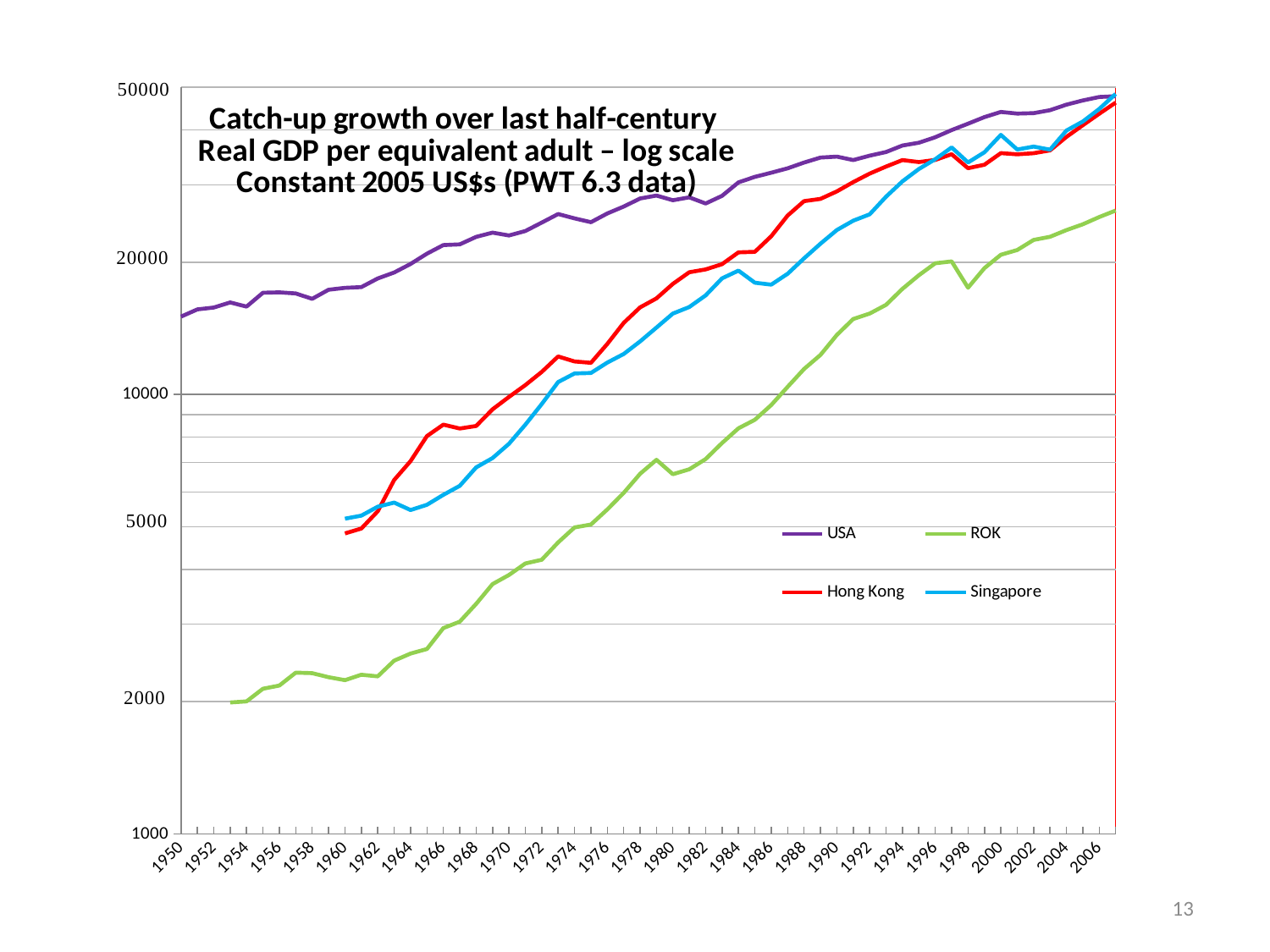
Which four series are listed in the legend? USA, ROK, Hong Kong, Singapore Which is lower in 2006, ROK or Hong Kong? ROK Does the USA series rise or fall over the period from 1950 to 2006? rise How many series does the legend list? 4 Which series has the lowest value in 2000? ROK Is the value for ROK in 1960 greater or less than 5000? less Which is higher in 1980, USA or ROK? USA What is the title of the chart? Catch-up growth over last half-century Real GDP per equivalent adult – log scale Constant 2005 US$s (PWT 6.3 data) Is the value for USA in 1950 greater or less than 10000? greater Is the value for Hong Kong in 1990 greater or less than 20000? greater What kind of chart is shown on the slide? line chart Which series has the highest value in 1970? USA